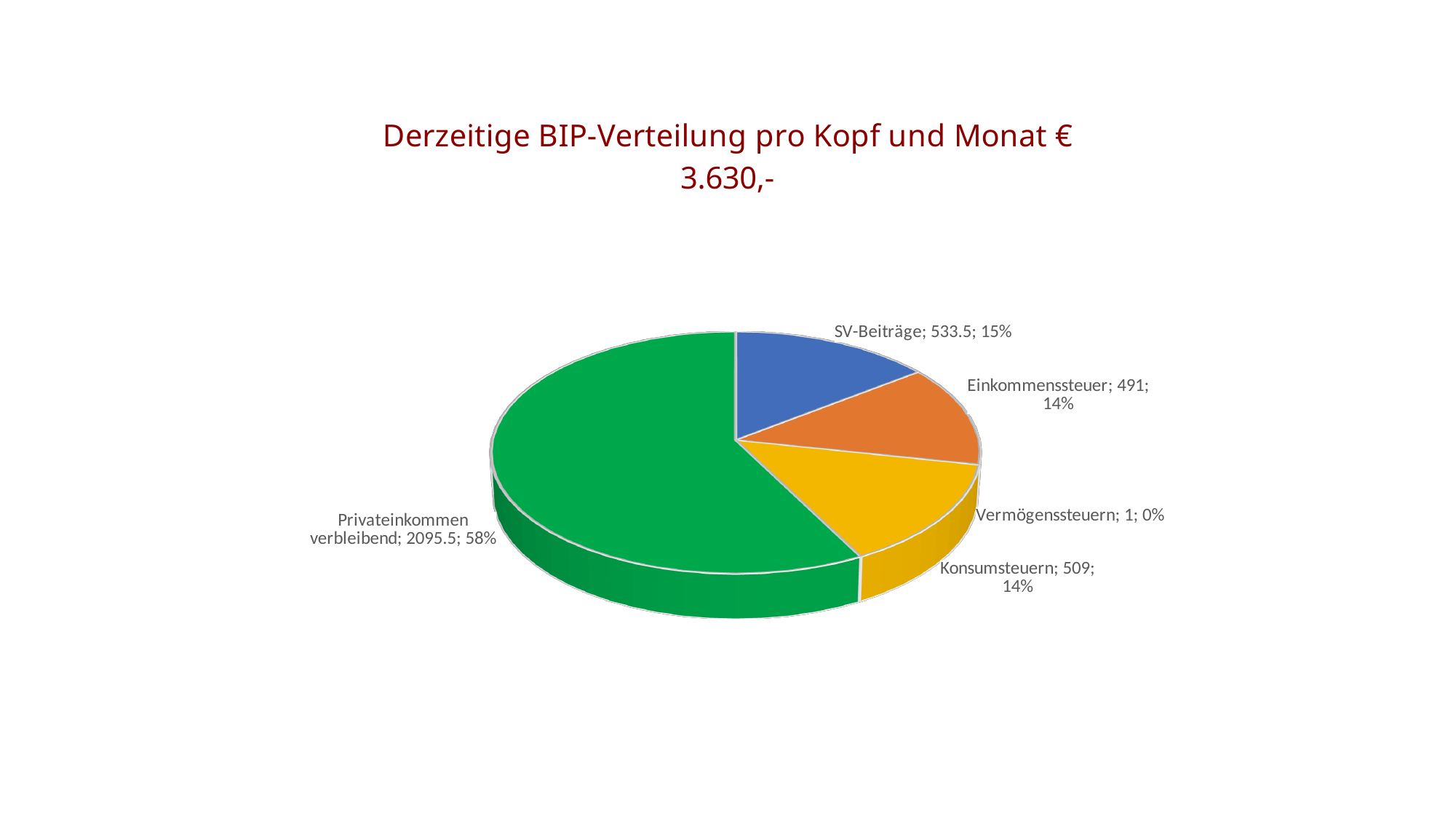
What is the difference between the values for SV-Beiträge and Einkommenssteuer? 42.5 What percentage share does SV-Beiträge have? 15% What percentage share does Privateinkommen verbleibend have? 58% What is the value for Einkommenssteuer? 491 What is the value for Privateinkommen verbleibend? 2095.5 Which is larger, the value for Konsumsteuern or the value for Einkommenssteuer? Konsumsteuern What type of chart is shown on the slide? Pie chart Which category has the smallest slice? Vermögenssteuern What is the value for SV-Beiträge? 533.5 What is the value for Konsumsteuern? 509 How many categories are shown in the pie chart? 5 Which category has the largest slice? Privateinkommen verbleibend